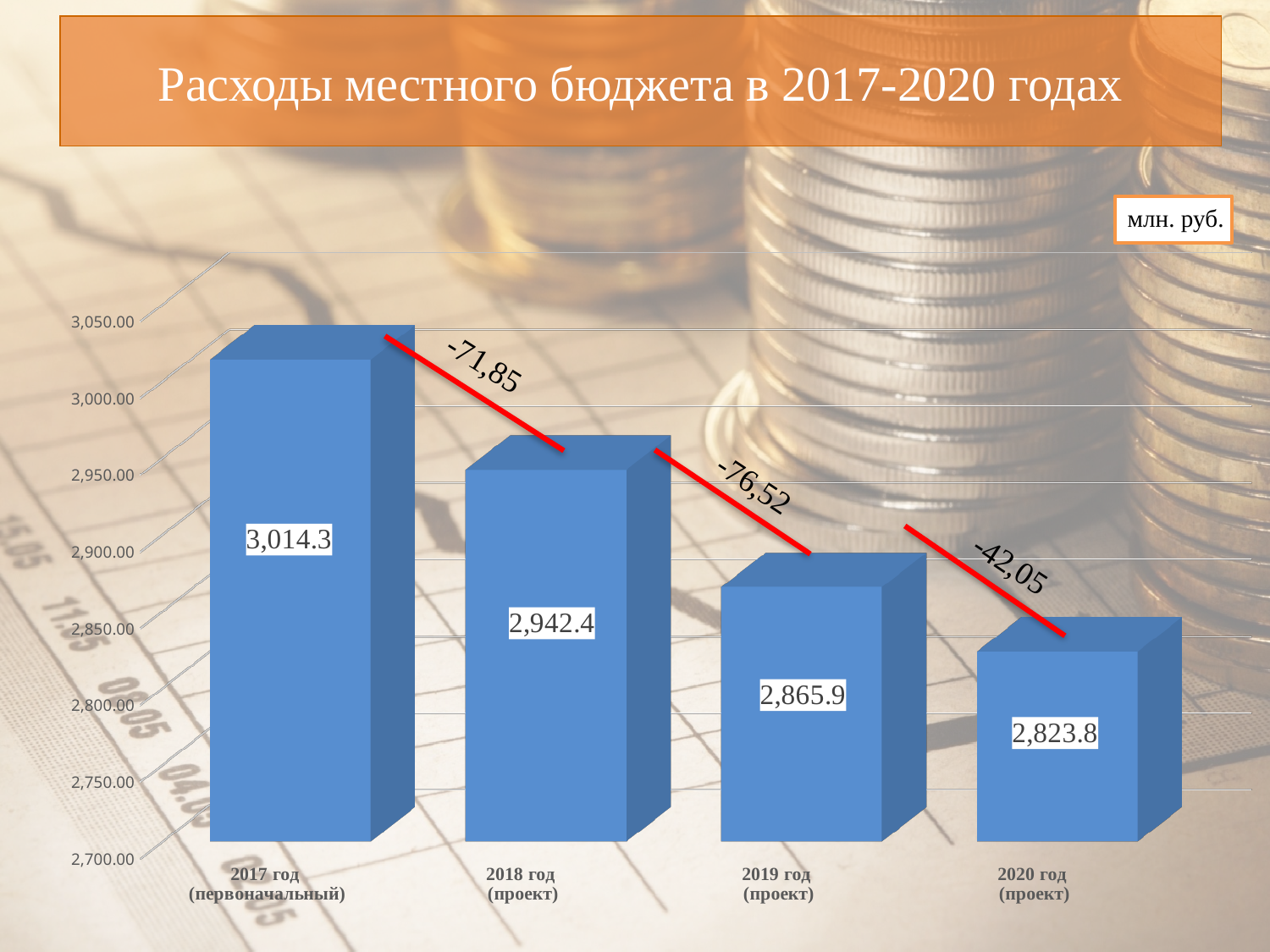
Which year has the highest value? 2017 год (первоначальный) What change is annotated on the red arrow between 2018 год (проект) and 2019 год (проект)? -76,52 How many bars are shown in the chart? 4 What is the value for 2019 год (проект)? 2,865.9 What is the value for 2018 год (проект)? 2,942.4 What kind of chart is shown on the slide? Bar chart Which is larger, the value for 2018 год (проект) or 2019 год (проект)? 2018 год (проект) What is the difference between the values for 2017 год (первоначальный) and 2020 год (проект)? 190.5 What is the value for 2020 год (проект)? 2,823.8 Do the values rise or fall from 2017 to 2020? Fall What is the value for 2017 год (первоначальный)? 3,014.3 Which year has the lowest value? 2020 год (проект)